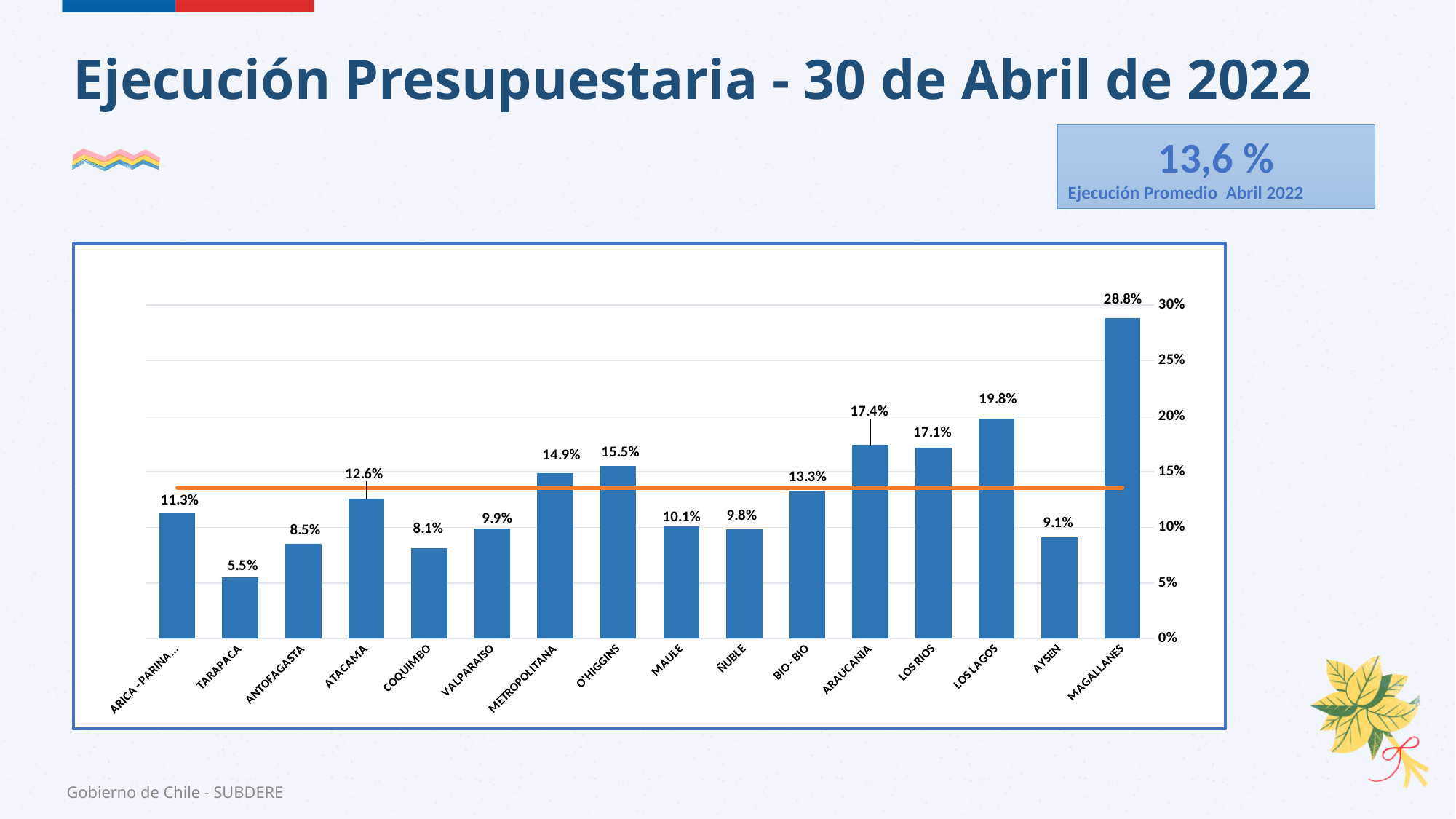
How many regions are shown on the x axis of the chart? 16 What kind of chart is shown on the slide? bar chart Which region has the lowest value? TARAPACA What is the value for METROPOLITANA? 14.9% What is the difference between the values for MAGALLANES and LOS LAGOS? 9.0% What is the value for TARAPACA? 5.5% Is the value for AYSEN greater or less than 10%? less What average value (Ejecución Promedio Abril 2022) is shown in the box above the chart? 13,6 % What is the value for LOS LAGOS? 19.8% Which region has the highest value? MAGALLANES What is the value for MAGALLANES? 28.8% Which is larger, the value for ARAUCANIA or the value for O'HIGGINS? ARAUCANIA